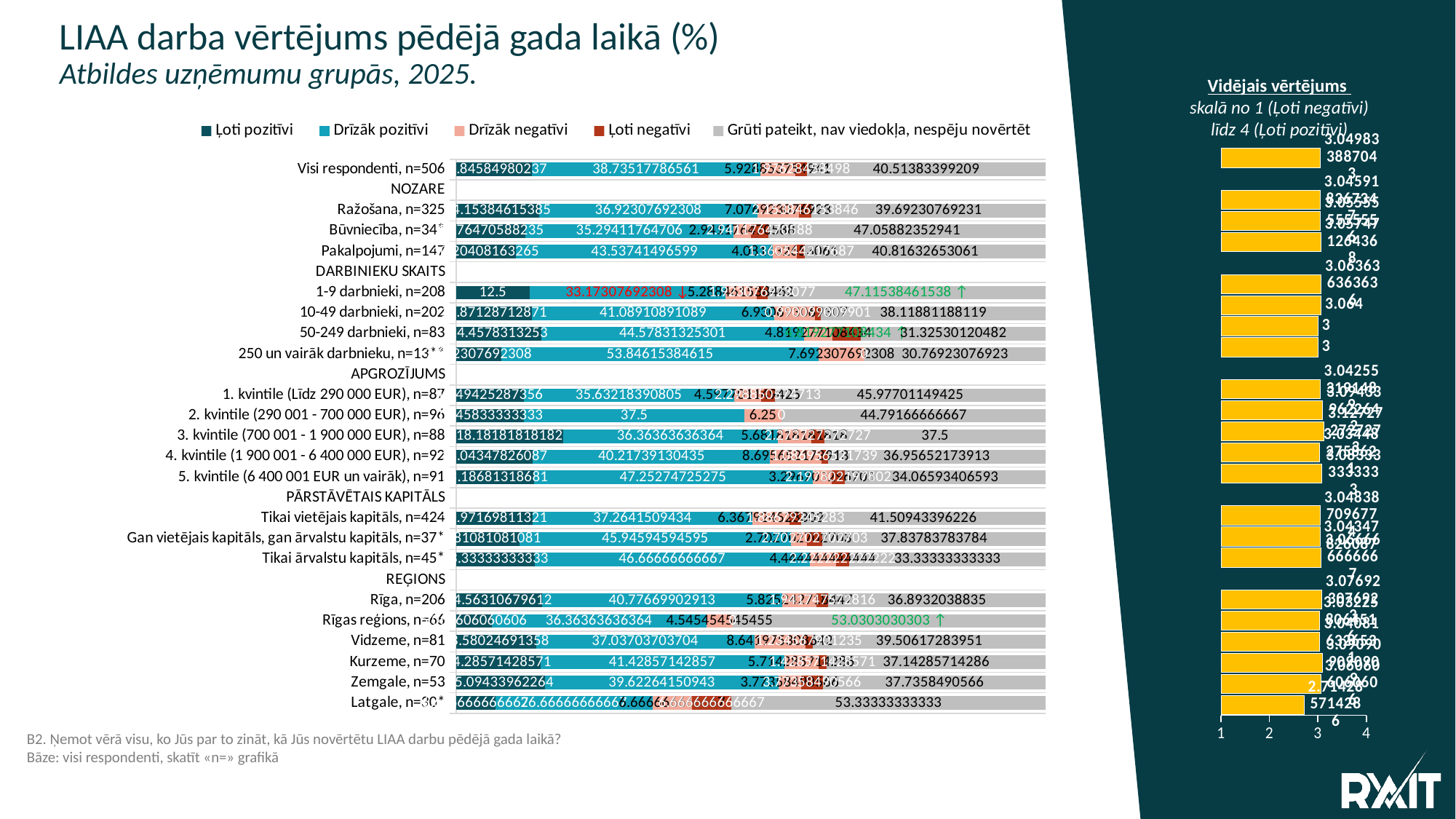
In the main chart, what is the 'Drīzāk pozitīvi' value for '250 un vairāk darbinieku, n=13'? 53.84615384615 In the main chart, which has the larger 'Drīzāk pozitīvi' value: 'Pakalpojumi, n=147' or 'Ražošana, n=325'? Pakalpojumi, n=147 What kind of chart is the main chart on the left of the slide? Bar chart How many series does the legend of the main chart list? 5 In the main chart, what is the 'Grūti pateikt, nav viedokļa, nespēju novērtēt' value for 'Rīgas reģions, n=66'? 53.0303030303 In the main chart, among the DARBINIEKU SKAITS groups, which has the lowest 'Drīzāk pozitīvi' value? 1-9 darbinieki, n=208 In the main chart, what is the difference between the 'Grūti pateikt, nav viedokļa, nespēju novērtēt' values for 'Būvniecība, n=34' and 'Ražošana, n=325'? 7.3665158371 In the main chart, what is the 'Ļoti pozitīvi' value for '1-9 darbinieki, n=208'? 12.5 In the main chart, what is the 'Grūti pateikt, nav viedokļa, nespēju novērtēt' value for 'Visi respondenti, n=506'? 40.51383399209 In the 'Vidējais vērtējums' chart on the right, is the average value for Latgale greater or less than 3? less In the main chart, what is the 'Drīzāk negatīvi' value for '2. kvintile (290 001 - 700 000 EUR), n=96'? 6.25 In the main chart, among the NOZARE groups (Ražošana, Būvniecība, Pakalpojumi), which has the highest 'Grūti pateikt, nav viedokļa, nespēju novērtēt' value? Būvniecība, n=34